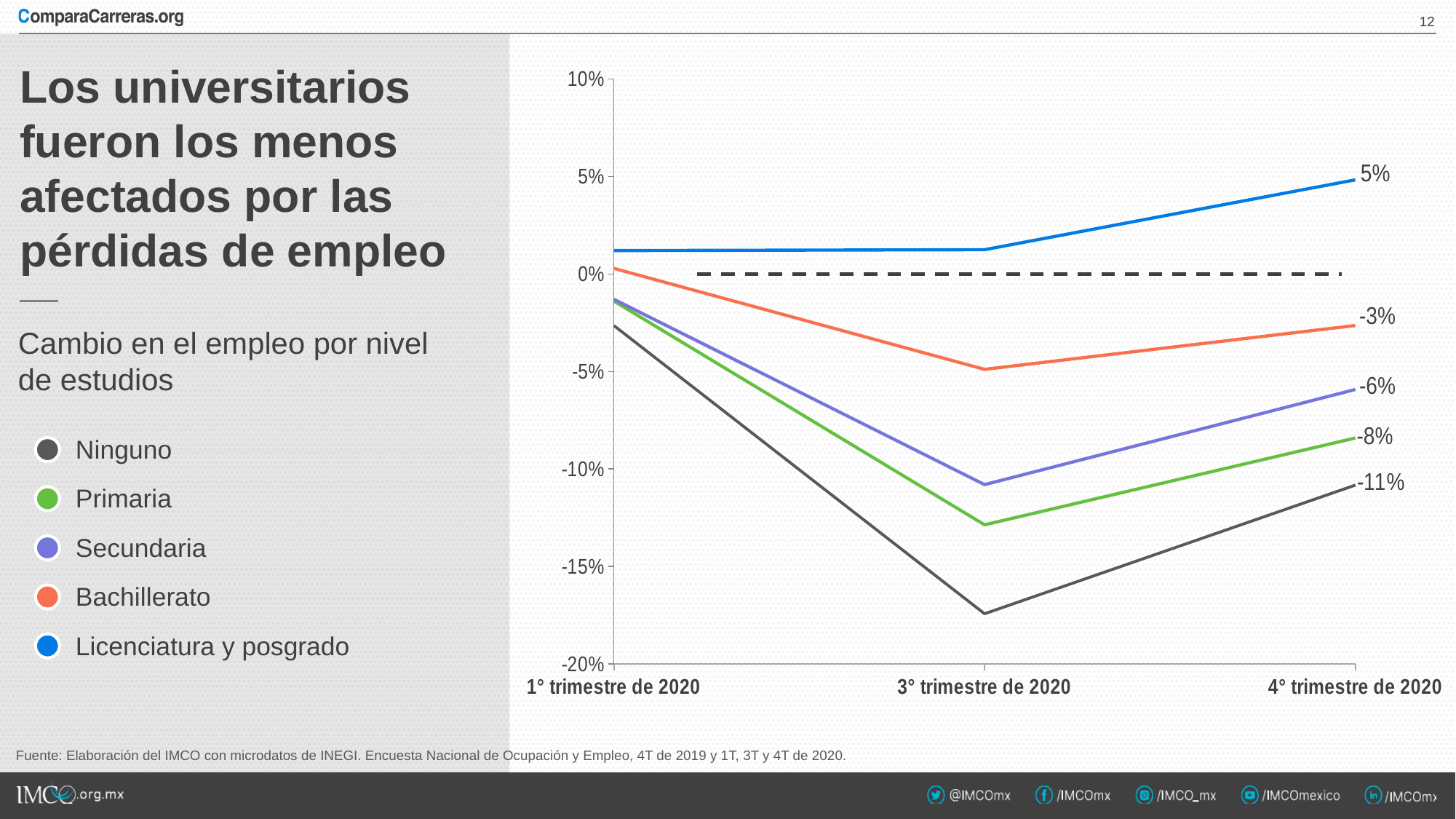
Which education level has the lowest value in 4° trimestre de 2020? Ninguno What is the value for Licenciatura y posgrado in 4° trimestre de 2020? 5% Is the value for Primaria in 3° trimestre de 2020 greater or less than -10%? less In 4° trimestre de 2020, which is higher: Secundaria or Primaria? Secundaria Is the value for Ninguno in 3° trimestre de 2020 greater or less than -15%? less What is the difference between the values for Licenciatura y posgrado and Ninguno in 4° trimestre de 2020? 16 percentage points What is the value for Bachillerato in 4° trimestre de 2020? -3% What is the value for Ninguno in 4° trimestre de 2020? -11% Which education level has the highest value in 4° trimestre de 2020? Licenciatura y posgrado What kind of chart is shown on the slide? line chart How many education levels does the legend list? 5 How many time periods are shown on the x axis? 3